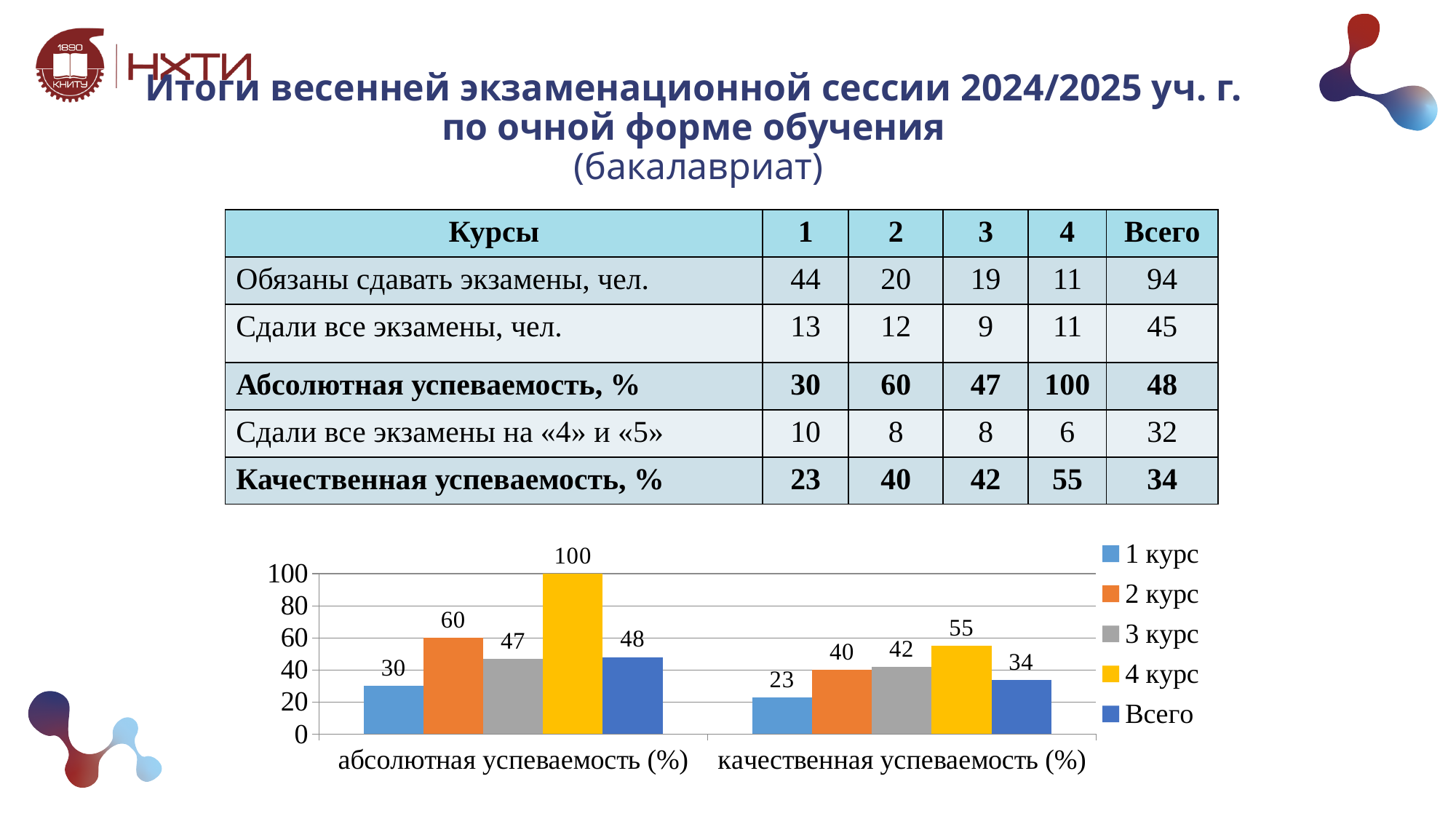
What is the difference between the 2 курс and 1 курс values in the абсолютная успеваемость (%) group? 30 Is the value for 3 курс in the абсолютная успеваемость (%) group greater or less than 40? greater How many categories are shown on the x axis of the chart? 2 What kind of chart is shown on the slide? bar chart Which series has the lowest value in the абсолютная успеваемость (%) group? 1 курс What is the value for Всего in the абсолютная успеваемость (%) group? 48 Which is larger in the качественная успеваемость (%) group: 2 курс or 3 курс? 3 курс What colour are the bars for 4 курс in the chart? yellow Which series has the highest value in the качественная успеваемость (%) group? 4 курс How many series does the chart legend list? 5 What is the value for 4 курс in the абсолютная успеваемость (%) group? 100 What is the value for 1 курс in the качественная успеваемость (%) group? 23